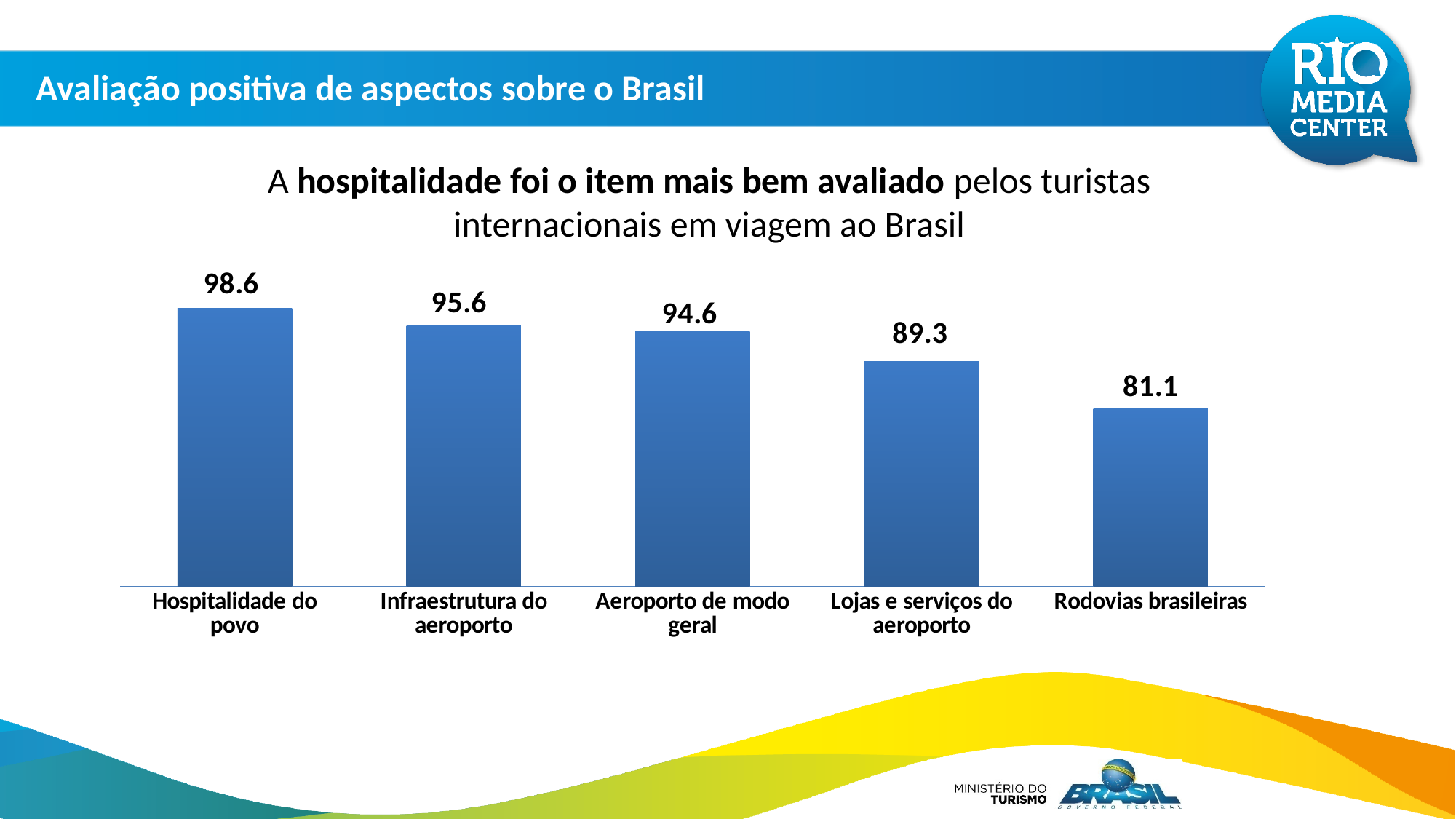
What kind of chart is shown on the slide? Bar chart What is the difference between the values for Infraestrutura do aeroporto and Lojas e serviços do aeroporto? 6.3 What is the difference between the values for Hospitalidade do povo and Rodovias brasileiras? 17.5 What is the value for Infraestrutura do aeroporto? 95.6 Which category has the lowest value? Rodovias brasileiras Which is larger, the value for Aeroporto de modo geral or the value for Lojas e serviços do aeroporto? Aeroporto de modo geral What is the value for Hospitalidade do povo? 98.6 What is the value for Rodovias brasileiras? 81.1 How many categories are shown in the chart? 5 What is the value for Aeroporto de modo geral? 94.6 What is the value for Lojas e serviços do aeroporto? 89.3 Which category has the highest value? Hospitalidade do povo